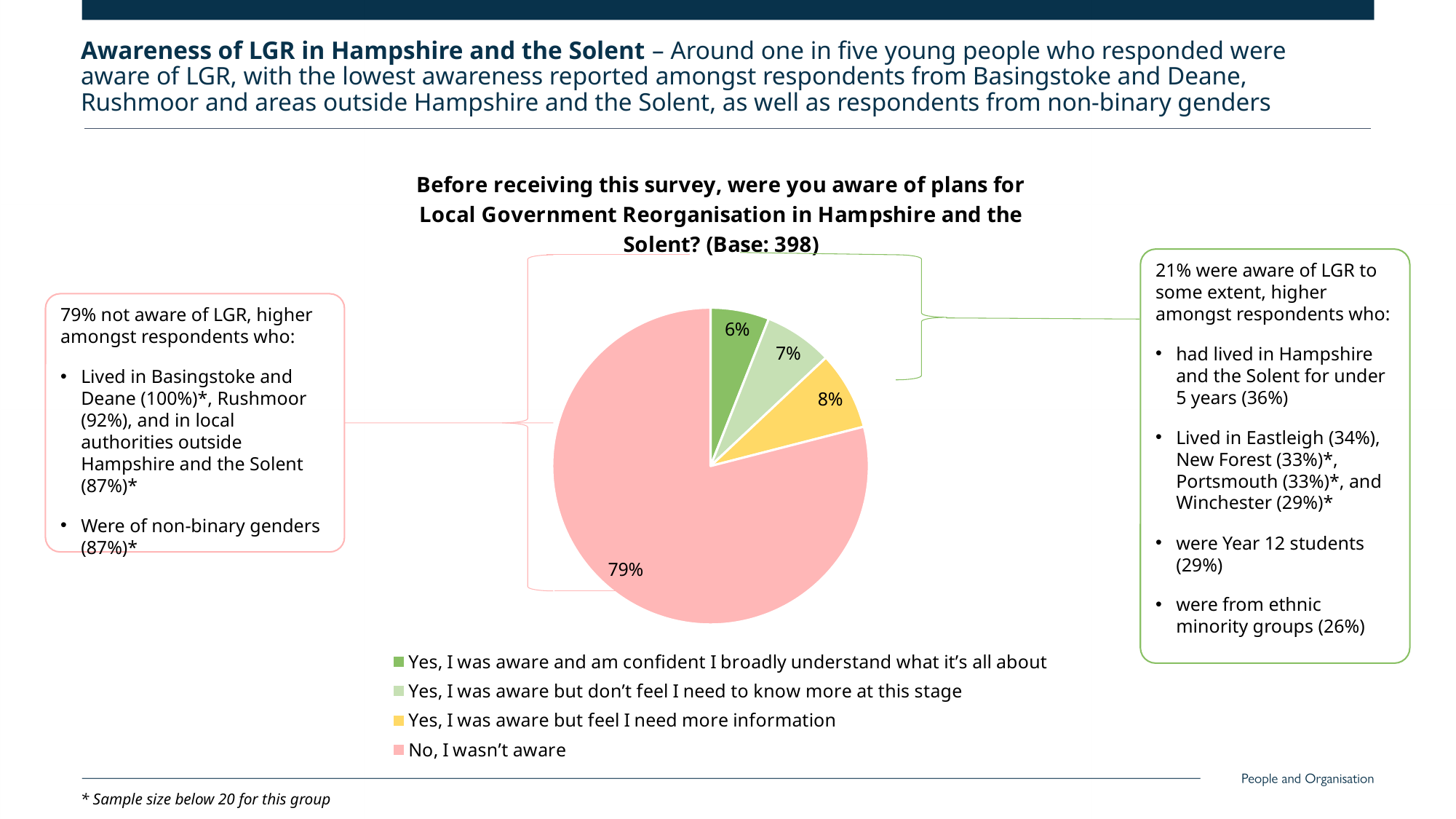
What share of respondents answered "Yes, I was aware but feel I need more information"? 8% Which is larger: the share for "Yes, I was aware but feel I need more information" or the share for "Yes, I was aware and am confident I broadly understand what it's all about"? Yes, I was aware but feel I need more information What share of respondents answered "No, I wasn't aware"? 79% Which response category has the largest slice of the pie? No, I wasn't aware What is the base (number of respondents) stated in the chart title? 398 What share of respondents answered "Yes, I was aware and am confident I broadly understand what it's all about"? 6% What colour is the slice for "No, I wasn't aware"? Pink How many response categories does the pie chart show? 4 What share of respondents answered "Yes, I was aware but don't feel I need to know more at this stage"? 7% Which response category has the smallest slice of the pie? Yes, I was aware and am confident I broadly understand what it's all about What kind of chart is shown on the slide? Pie chart What is the difference in percentage points between "No, I wasn't aware" and "Yes, I was aware but feel I need more information"? 71 percentage points